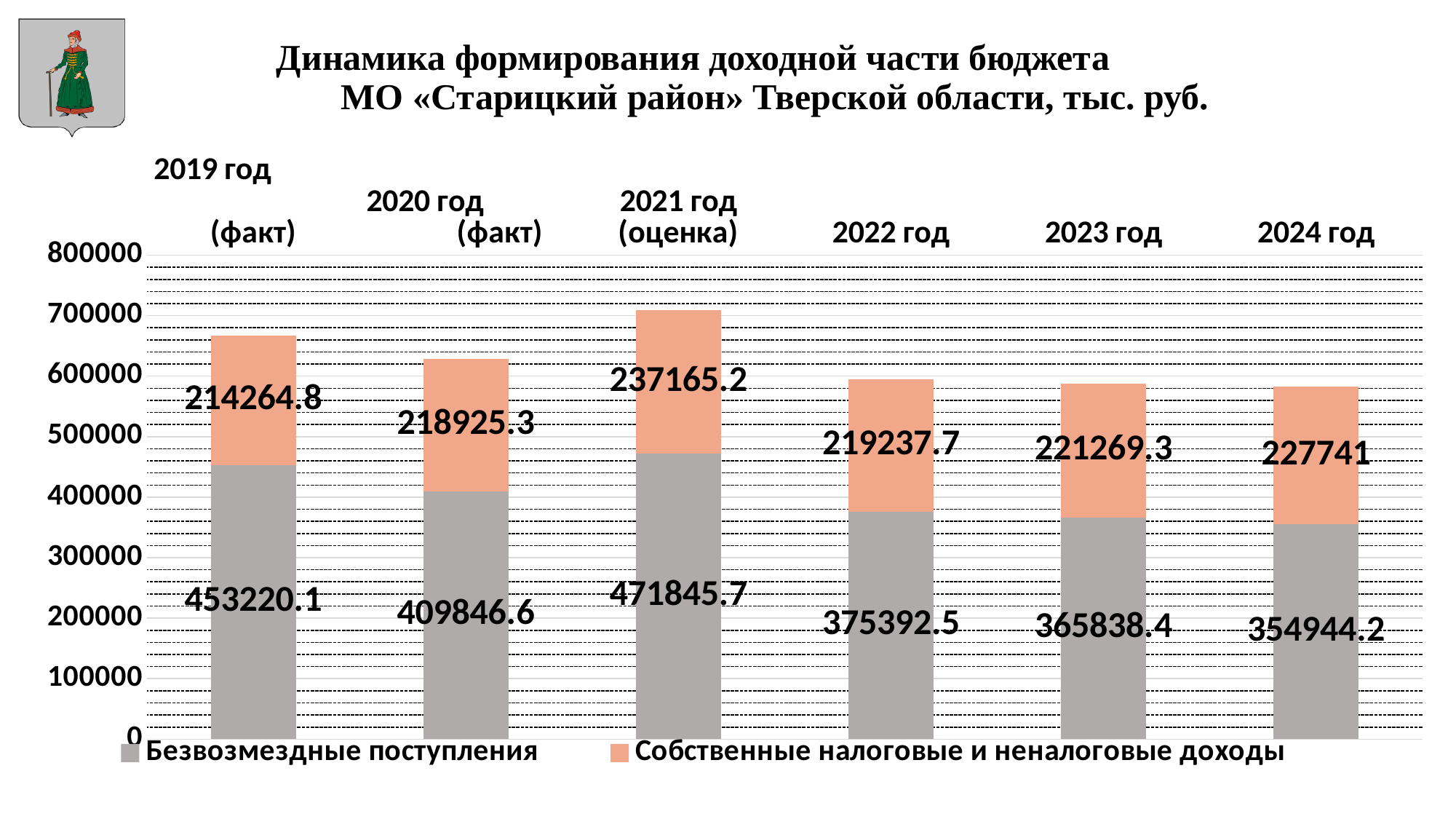
How many year categories are shown on the x axis? 6 How many series does the legend list? 2 Which is larger: Собственные налоговые и неналоговые доходы in 2023 год or in 2022 год? 2023 год What type of chart is shown on the slide? Stacked bar chart In which year is Безвозмездные поступления the highest? 2021 год (оценка) What is the difference between Безвозмездные поступления in 2019 год (факт) and in 2024 год? 98275.9 What is the total of the stacked bar for 2019 год (факт)? 667484.9 In which year is Безвозмездные поступления the lowest? 2024 год What is the value of Собственные налоговые и неналоговые доходы for 2021 год (оценка)? 237165.2 What is the value of Собственные налоговые и неналоговые доходы for 2024 год? 227741 Is the total of the stacked bar for 2024 год greater or less than 600000? less What is the value of Безвозмездные поступления for 2019 год (факт)? 453220.1